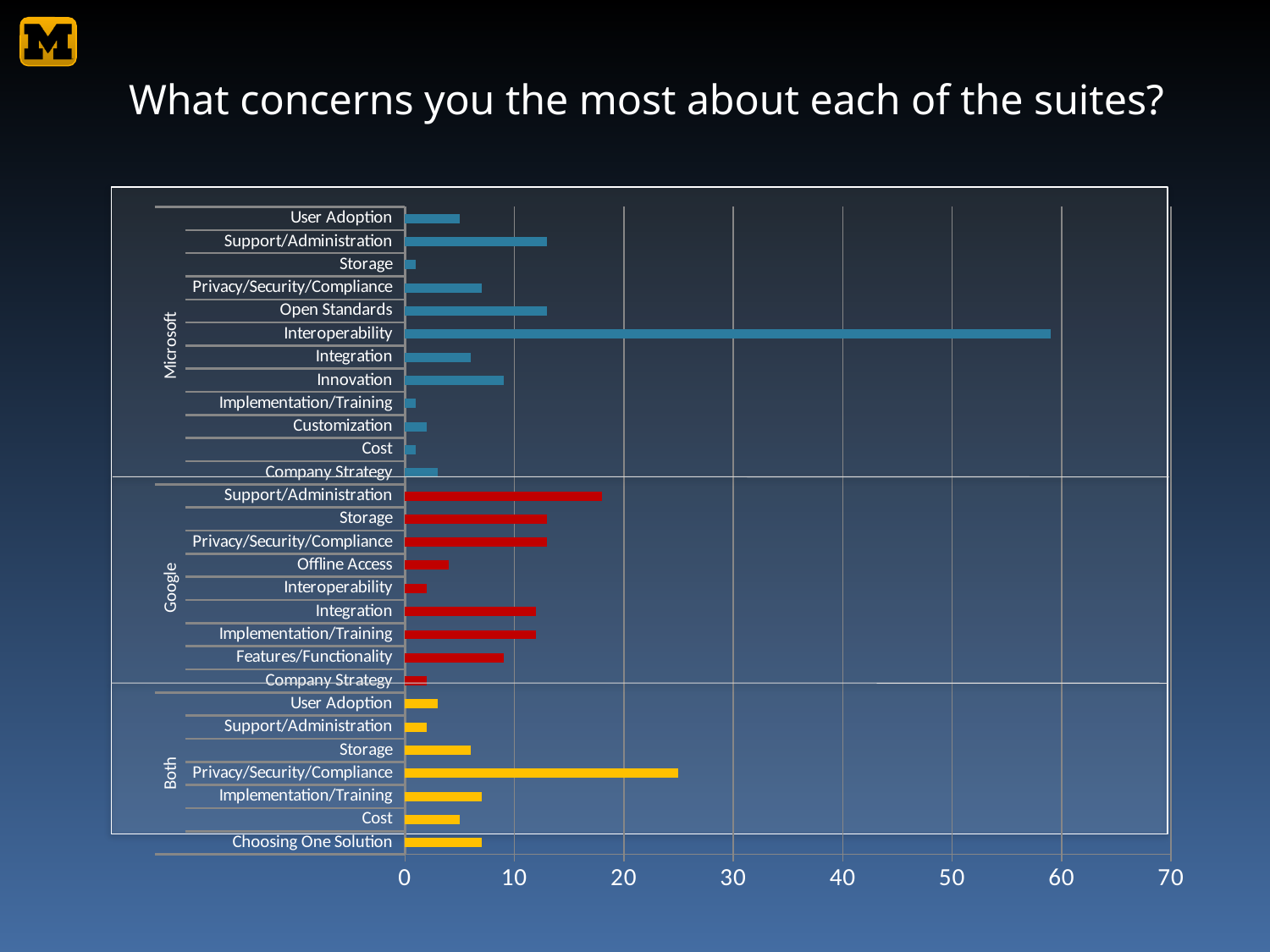
How many concern categories are listed under the Microsoft group? 12 Is the value for Interoperability under Microsoft greater or less than 50? greater Which is larger: Support/Administration under Microsoft or User Adoption under Microsoft? Support/Administration Is the value for Privacy/Security/Compliance under Both greater or less than 20? greater Within the Google group, which concern has the longest bar? Support/Administration What is the title of the slide containing the chart? What concerns you the most about each of the suites? What kind of chart is shown on the slide? bar chart Which category has the longest bar in the whole chart? Interoperability (Microsoft) Which is larger: Support/Administration under Google or Storage under Google? Support/Administration Is the value for Support/Administration under Google greater or less than 20? less Within the Both group, which concern has the longest bar? Privacy/Security/Compliance